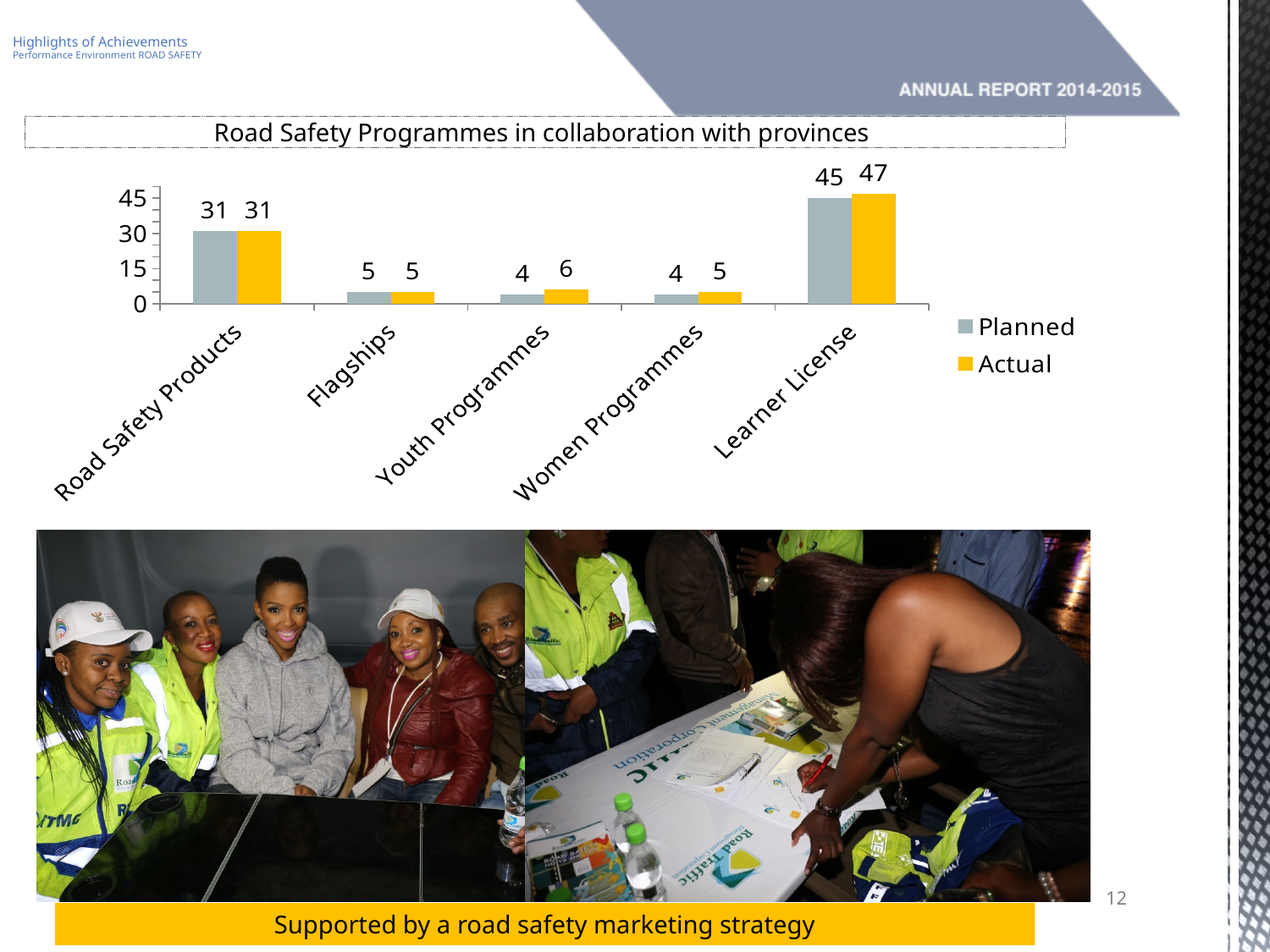
Which category has the highest Actual value? Learner License What is the Planned value for Road Safety Products? 31 What is the difference between the Actual and Planned values for Learner License? 2 Is the Actual value for Women Programmes larger or smaller than the Planned value for Women Programmes? larger Which category has the lowest Planned value? Youth Programmes and Women Programmes (both 4) What is the Actual value for Learner License? 47 How many categories are shown on the x axis? 5 What is the Actual value for Youth Programmes? 6 Is the Planned value for Learner License greater or less than 30? greater What kind of chart is shown on the slide? bar chart How many series does the legend list? 2 What is the title of the chart? Road Safety Programmes in collaboration with provinces